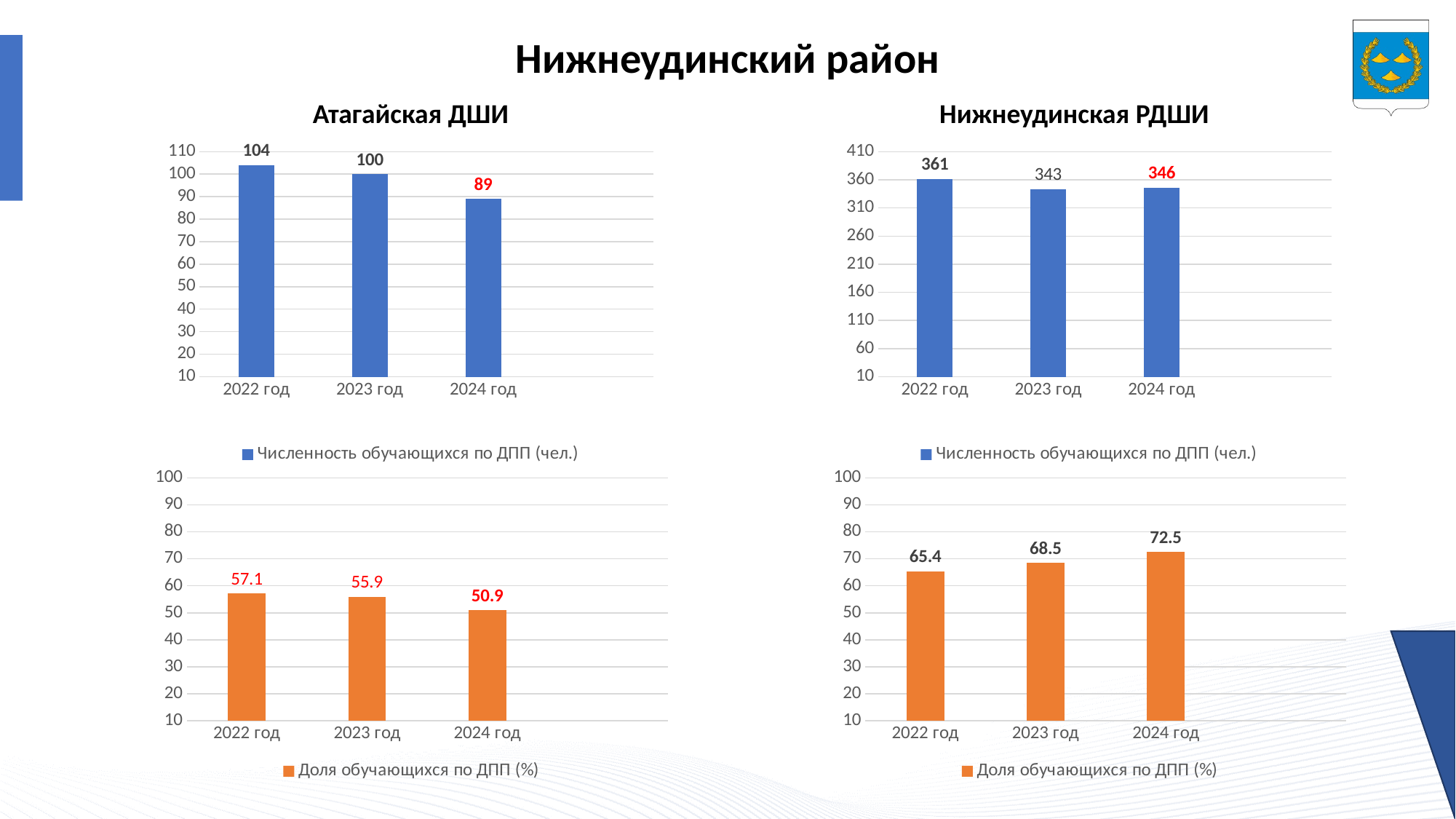
In the top-right chart (Нижнеудинская РДШИ, Численность обучающихся по ДПП), which year has the highest value? 2022 год In the top-left chart (Атагайская ДШИ, Численность обучающихся по ДПП), which year has the lowest value? 2024 год In the top-left chart (Атагайская ДШИ, Численность обучающихся по ДПП), what is the difference between the 2022 год and 2024 год values? 15 In the top-right chart (Нижнеудинская РДШИ, Численность обучающихся по ДПП), which is larger: the value for 2023 год or 2024 год? 2024 год How many categories (years) are shown in the bottom-right chart (Нижнеудинская РДШИ, Доля обучающихся по ДПП)? 3 What type of chart is the top-left chart (Атагайская ДШИ, Численность обучающихся по ДПП)? bar chart In the bottom-right chart (Нижнеудинская РДШИ, Доля обучающихся по ДПП), what is the value for 2024 год? 72.5 In the bottom-right chart (Нижнеудинская РДШИ, Доля обучающихся по ДПП), what is the difference between the 2024 год and 2022 год values? 7.1 In the top-left chart (Атагайская ДШИ, Численность обучающихся по ДПП), what is the value for 2022 год? 104 In the bottom-left chart (Атагайская ДШИ, Доля обучающихся по ДПП), what is the value for 2023 год? 55.9 In the bottom-left chart (Атагайская ДШИ, Доля обучающихся по ДПП), do the values rise or fall from 2022 год to 2024 год? fall In the top-right chart (Нижнеудинская РДШИ, Численность обучающихся по ДПП), what is the value for 2023 год? 343